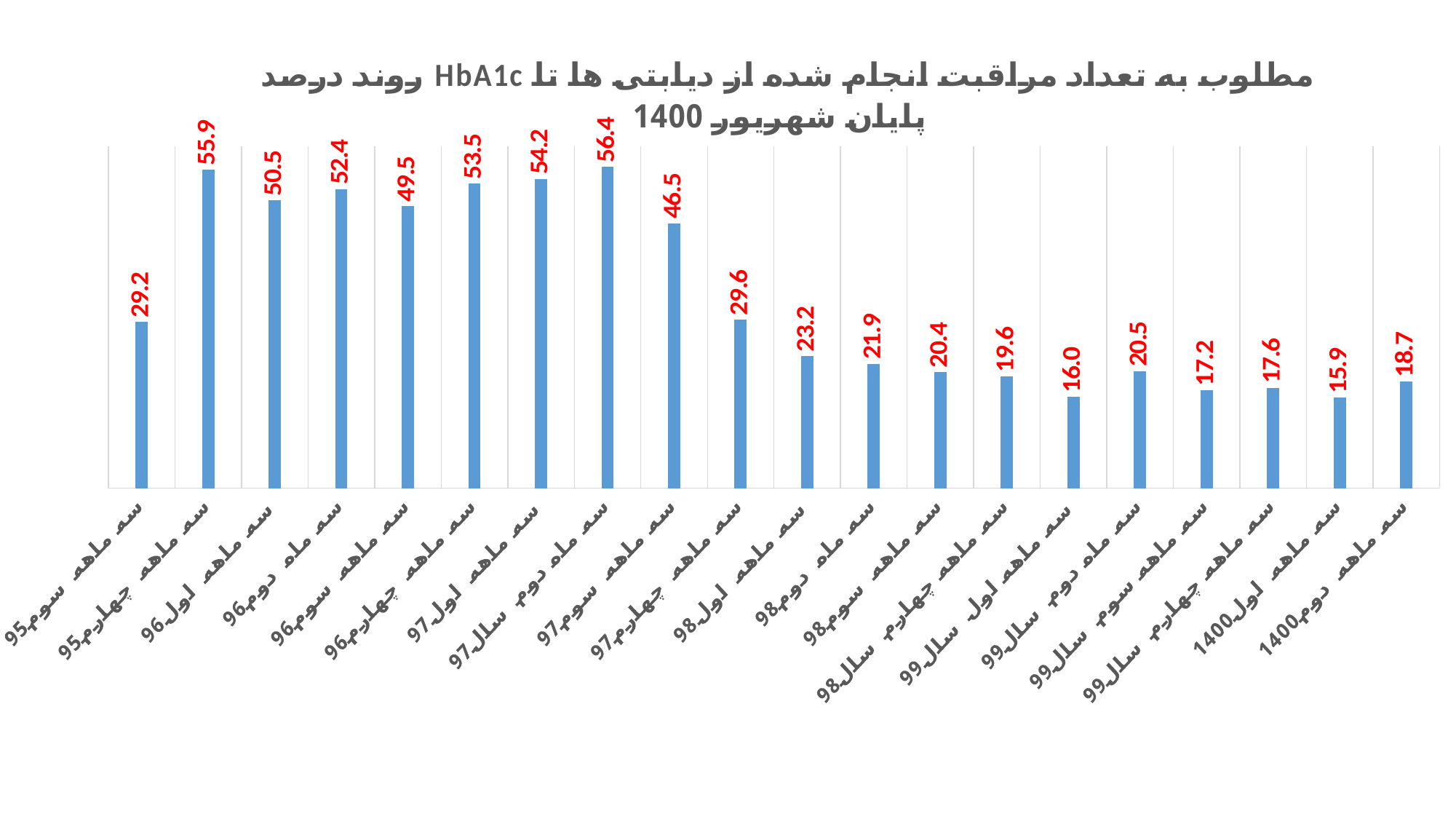
What colour are the bars in the chart? blue How many bars (categories) are plotted in the chart? 20 Which category has the lowest value? سه ماهه اول1400 What is the value for سه ماهه دوم1400? 18.7 What is the difference between the values for سه ماهه چهارم95 and سه ماهه سوم95? 26.7 What is the value for سه ماهه دوم سال97? 56.4 What is the value for سه ماهه سوم95? 29.2 What type of chart is shown on the slide? bar chart Which is larger, the value for سه ماهه سوم97 or the value for سه ماهه چهارم97? سه ماهه سوم97 Which category has the highest value? سه ماهه دوم سال97 Do the values generally rise or fall from سه ماهه دوم سال97 to سه ماهه اول سال99? fall What is the value for سه ماهه اول سال99? 16.0